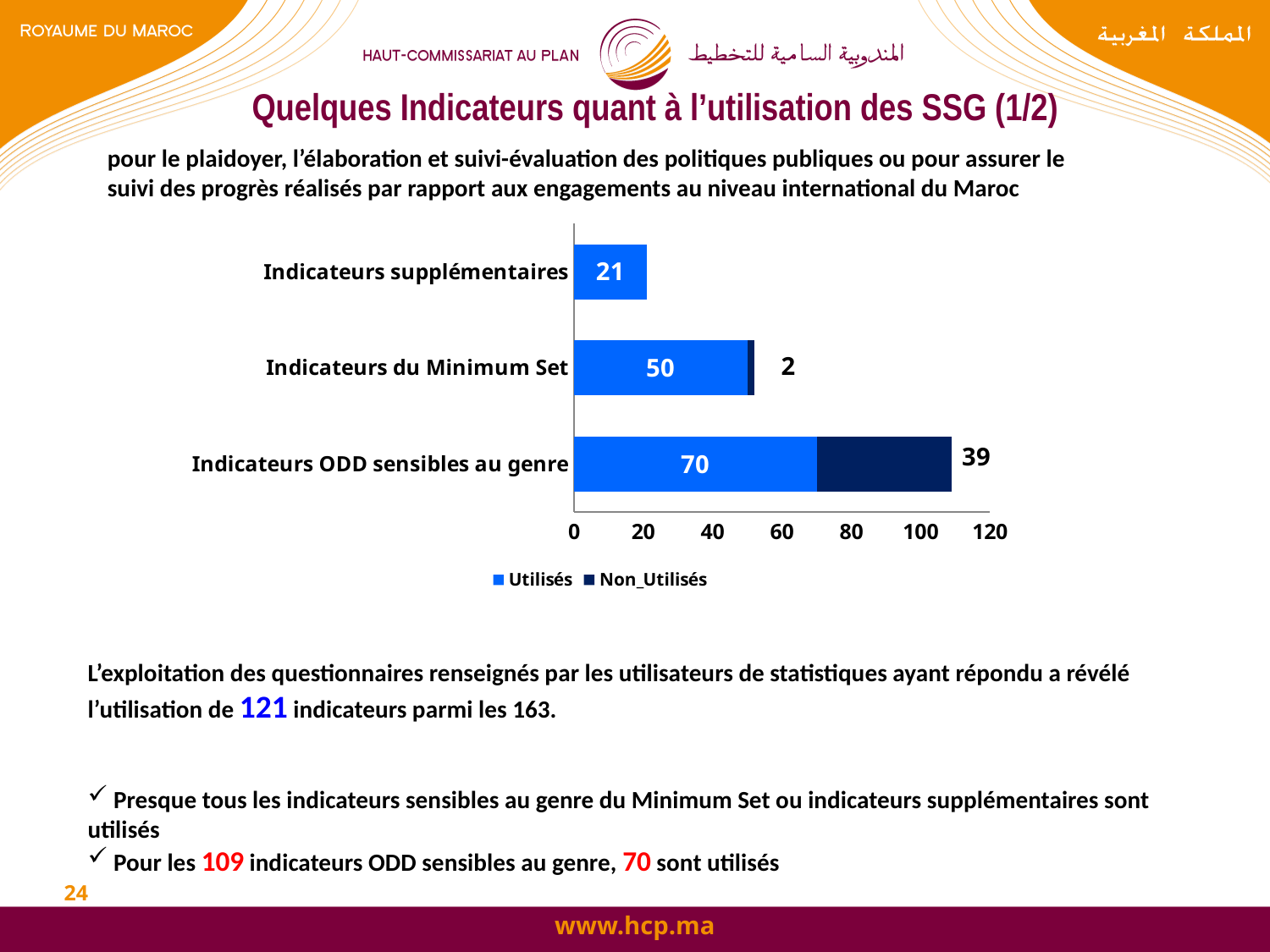
What is the Utilisés value for Indicateurs ODD sensibles au genre? 70 What is the Non_Utilisés value for Indicateurs du Minimum Set? 2 How many categories are plotted on the chart? 3 Which category has the lowest Utilisés value? Indicateurs supplémentaires Which series is shown in dark navy blue in the legend? Non_Utilisés Which category has the highest Utilisés value? Indicateurs ODD sensibles au genre What type of chart is shown on the slide? Stacked bar chart What is the Non_Utilisés value for Indicateurs ODD sensibles au genre? 39 How many series does the legend list? 2 What is the difference between the Utilisés values for Indicateurs ODD sensibles au genre and Indicateurs du Minimum Set? 20 What is the total of the stacked bar for Indicateurs ODD sensibles au genre? 109 What is the Utilisés value for Indicateurs supplémentaires? 21